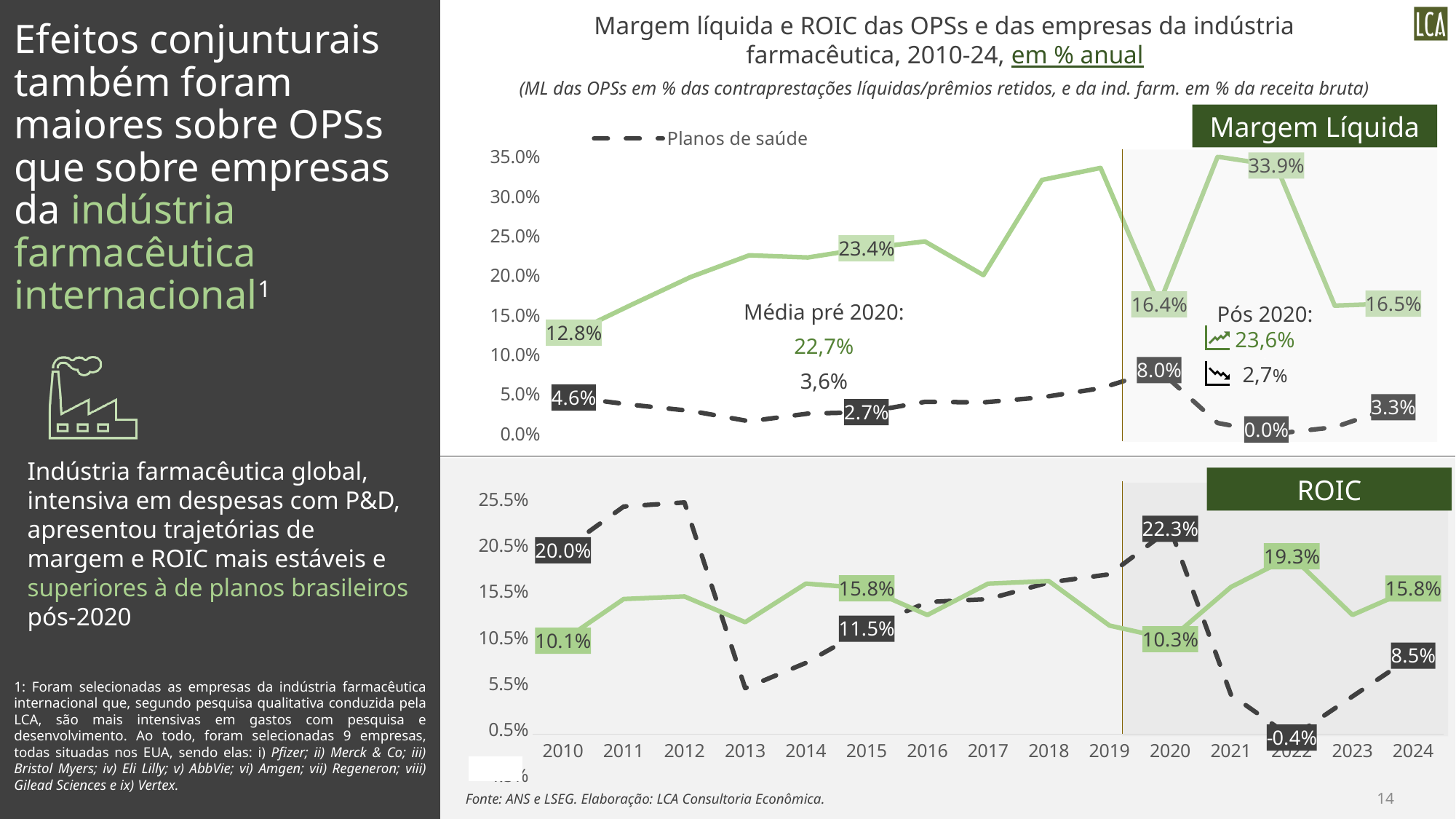
In the ROIC chart, what is the labelled value for Planos de saúde in 2020? 22.3% In the ROIC chart, is the Planos de saúde value in 2013 greater or less than 10.5%? less In the Margem Líquida chart, what is the labelled value for Planos de saúde in 2010? 4.6% In the ROIC chart, what is the labelled value for Planos de saúde in 2022? -0.4% How many years are shown on the x axis of the charts? 15 In the Margem Líquida chart, what is the difference between the green line's 2015 value and the Planos de saúde value in 2015? 20.7 percentage points In the Margem Líquida chart, what is the labelled value of the green line (indústria farmacêutica) in 2022? 33.9% What type of chart is used for the Margem Líquida and ROIC panels? Line chart In the ROIC chart, what is the labelled value of the green line in 2024? 15.8% In the ROIC chart, what is the difference between the green line's value and the Planos de saúde value in 2010? 9.9 percentage points In the Margem Líquida chart, which series has the higher value in 2020: the green line or Planos de saúde? The green line (16.4% vs 8.0%) In the Margem Líquida chart, what is the labelled value for Planos de saúde in 2022? 0.0%